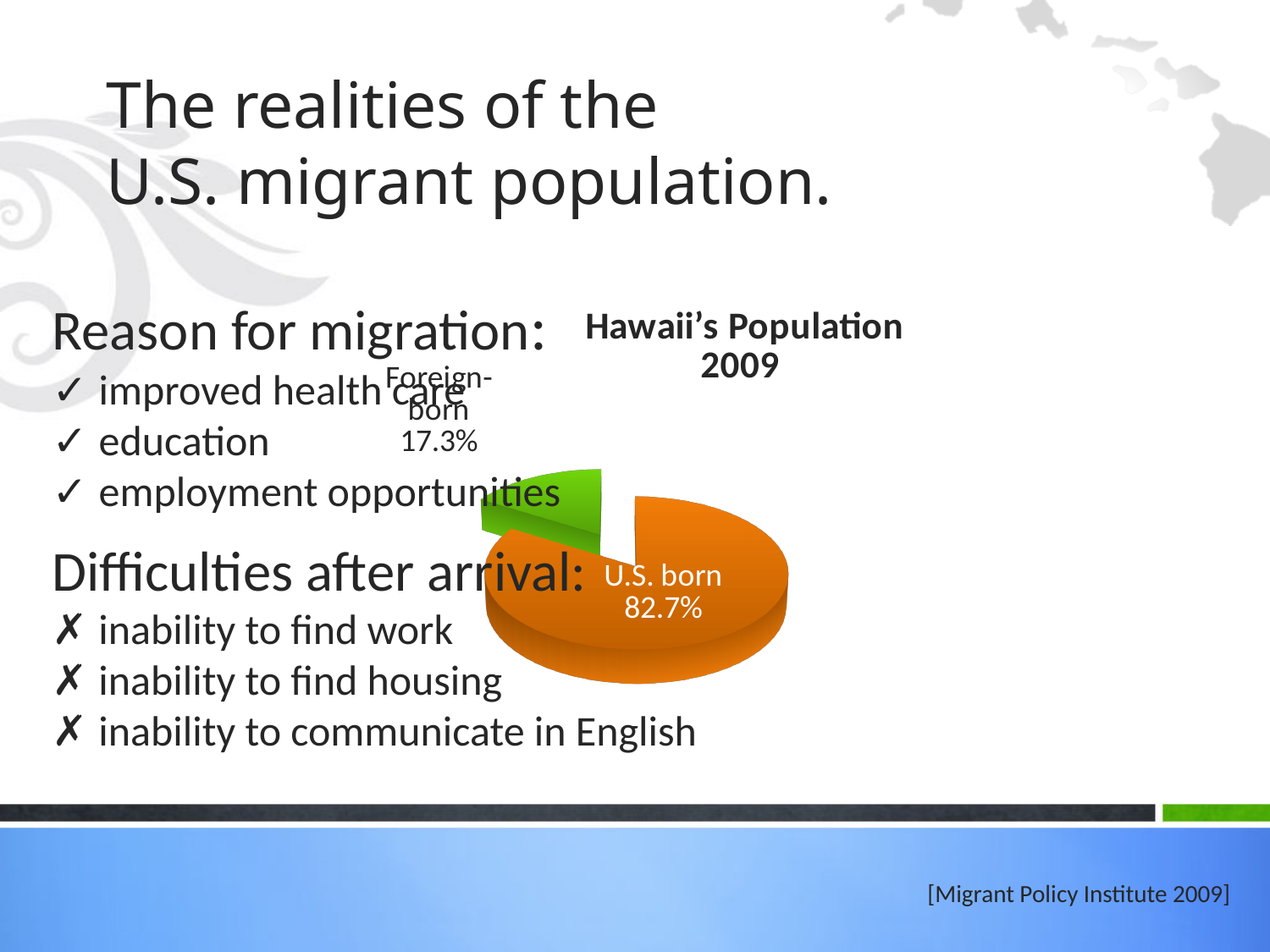
What is the difference in percentage points between the U.S. born share and the foreign-born share? 65.4 What is the title of the chart? Hawaii's Population 2009 What share of Hawaii's population in 2009 is U.S. born? 82.7% Which is larger, the U.S. born share or the foreign-born share? U.S. born What colour is the U.S. born slice of the pie? orange Which slice of the pie is the smallest? Foreign-born What share of Hawaii's population in 2009 is foreign-born? 17.3% How many slices does the pie chart have? 2 What kind of chart is shown on the slide? pie chart Is the foreign-born share greater or less than 20%? less Which slice of the pie is the largest? U.S. born